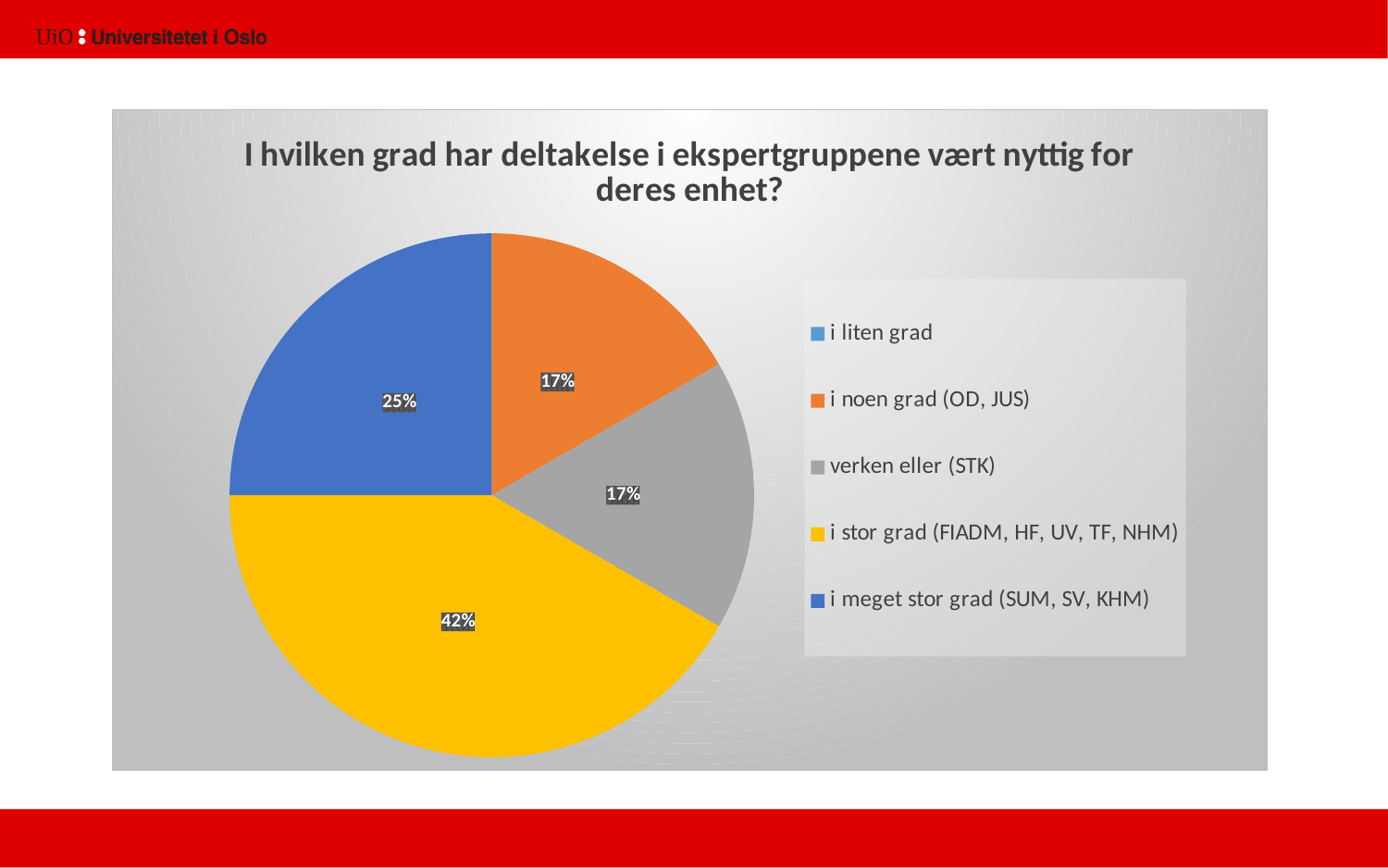
Which is larger, the slice for "i meget stor grad (SUM, SV, KHM)" or the slice for "i noen grad (OD, JUS)"? i meget stor grad (SUM, SV, KHM) How many slices are visible in the pie? 4 What is the difference in percentage points between the "i stor grad (FIADM, HF, UV, TF, NHM)" slice and the "i meget stor grad (SUM, SV, KHM)" slice? 17 What share of the pie does "i stor grad (FIADM, HF, UV, TF, NHM)" have? 42% What kind of chart is shown on the slide? pie chart What share of the pie does "i noen grad (OD, JUS)" have? 17% What share of the pie does "i meget stor grad (SUM, SV, KHM)" have? 25% What colour is the slice for "i stor grad (FIADM, HF, UV, TF, NHM)"? yellow What is the title of the chart? I hvilken grad har deltakelse i ekspertgruppene vært nyttig for deres enhet? How many entries does the legend list? 5 Which category has the largest slice of the pie? i stor grad (FIADM, HF, UV, TF, NHM)